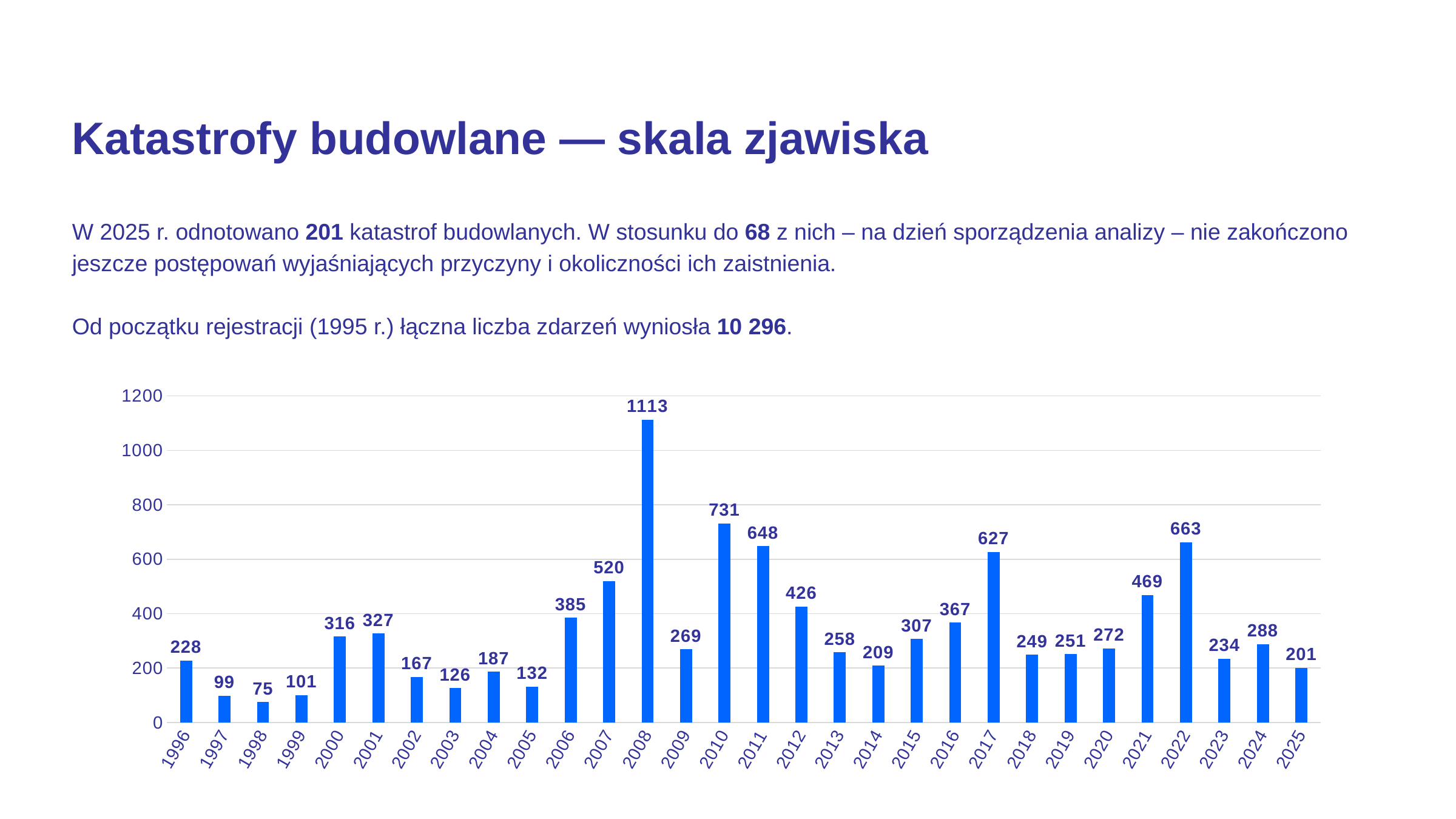
Is the value for 2007 greater or less than 400? greater Which is larger, the value for 2017 or the value for 2022? 2022 How many years are shown on the x axis? 30 What is the difference between the values for 2008 and 2010? 382 Which year has the lowest value? 1998 Do the values rise or fall from 1996 to 1998? fall What kind of chart is shown on the slide? bar chart What is the difference between the values for 2024 and 2023? 54 What value is shown for 2017? 627 Which year has the highest value? 2008 What value is shown for 2025? 201 What value is shown for 2008? 1113